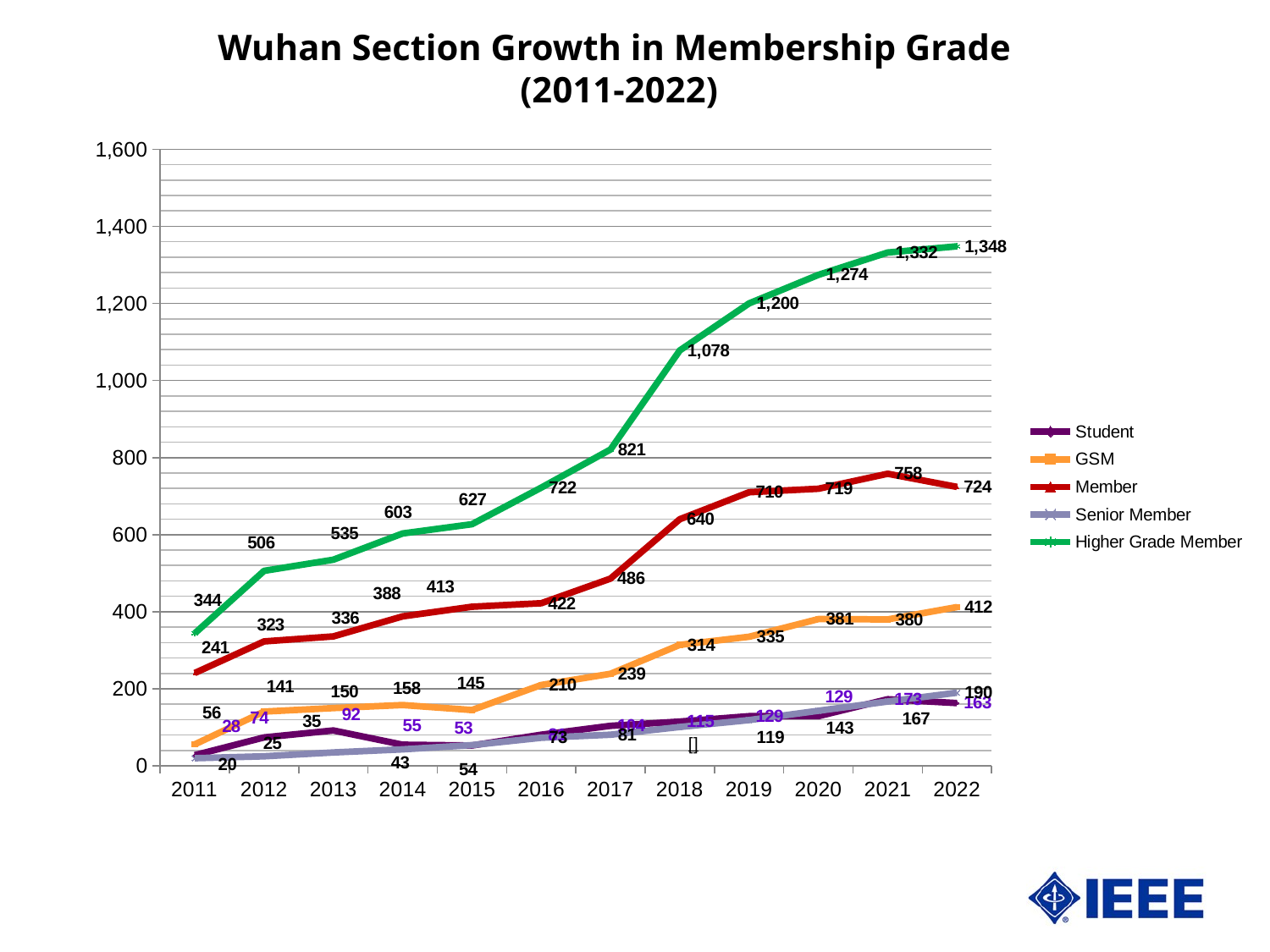
What is the value for Senior Member in 2022? 190 What is the value for Higher Grade Member in 2022? 1,348 What is the value for Member in 2018? 640 Does the Higher Grade Member series rise or fall from 2011 to 2022? Rise How many years are plotted on the x axis? 12 Which is larger in 2022, the Member value or the GSM value? Member In which year is the Higher Grade Member value lowest? 2011 How many series does the legend list? 5 What is the difference between the Higher Grade Member values in 2022 and 2011? 1,004 What is the value for GSM in 2011? 56 What kind of chart is shown on the slide? Line chart In which year does the Member series reach its highest value? 2021